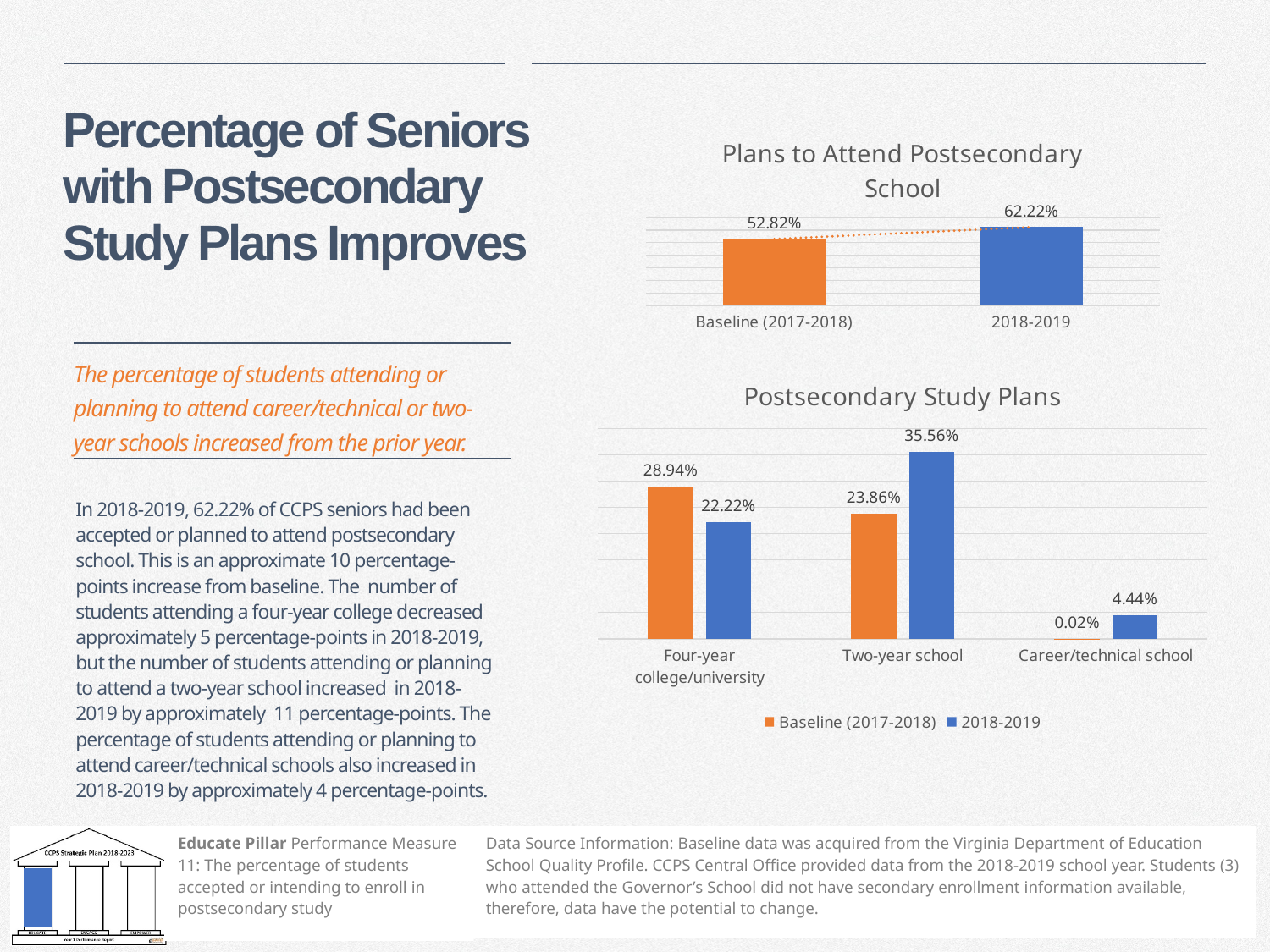
In the 'Postsecondary Study Plans' chart, which category has the highest 2018-2019 value? Two-year school In the 'Postsecondary Study Plans' chart, what is the difference between the 2018-2019 and Baseline (2017-2018) values for Two-year school? 11.70 percentage points In the 'Plans to Attend Postsecondary School' chart, how many bars are plotted? 2 In the 'Plans to Attend Postsecondary School' chart, what is the value for 2018-2019? 62.22% In the 'Postsecondary Study Plans' chart, which is larger for Four-year college/university: the Baseline (2017-2018) value or the 2018-2019 value? Baseline (2017-2018) What type of chart is the 'Postsecondary Study Plans' chart? Bar chart In the 'Postsecondary Study Plans' chart, what is the Baseline (2017-2018) value for Career/technical school? 0.02% In the 'Plans to Attend Postsecondary School' chart, what is the value for Baseline (2017-2018)? 52.82% How many series does the legend of the 'Postsecondary Study Plans' chart list? 2 In the 'Postsecondary Study Plans' chart, what is the 2018-2019 value for Two-year school? 35.56% In the 'Plans to Attend Postsecondary School' chart, by how many percentage points does 2018-2019 exceed Baseline (2017-2018)? 9.40 percentage points In the 'Postsecondary Study Plans' chart, which category has the lowest Baseline (2017-2018) value? Career/technical school